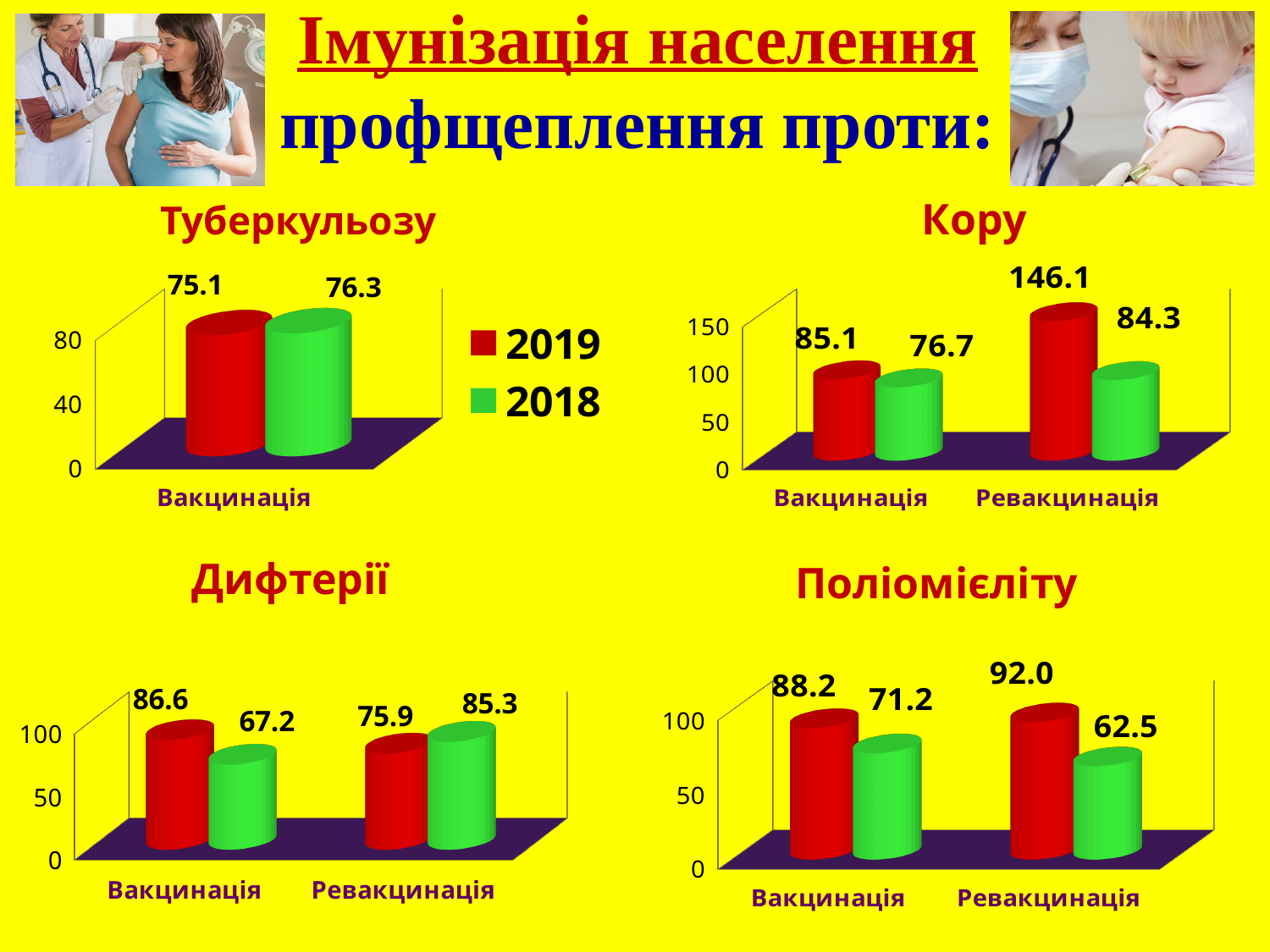
In the Кору chart, what is the difference between the 2019 and 2018 values for Вакцинація? 8.4 How many series does the legend on the slide list? 2 In the Поліомієліту chart, what is the difference between the 2019 and 2018 values for Вакцинація? 17.0 In the Кору chart, what is the value for 2019 for Ревакцинація? 146.1 In the Дифтерії chart, which is larger for Ревакцинація, the 2019 value or the 2018 value? 2018 In the Поліомієліту chart, what is the lowest value shown? 62.5 In the Кору chart, which category has the highest value? Ревакцинація (2019) In the Туберкульозу chart, what is the value for 2018 for Вакцинація? 76.3 In the Дифтерії chart, what is the value for 2018 for Вакцинація? 67.2 In the Поліомієліту chart, what is the value for 2019 for Ревакцинація? 92.0 In the Туберкульозу chart, what is the value for 2019 for Вакцинація? 75.1 What kind of chart is the Дифтерії chart? Bar chart